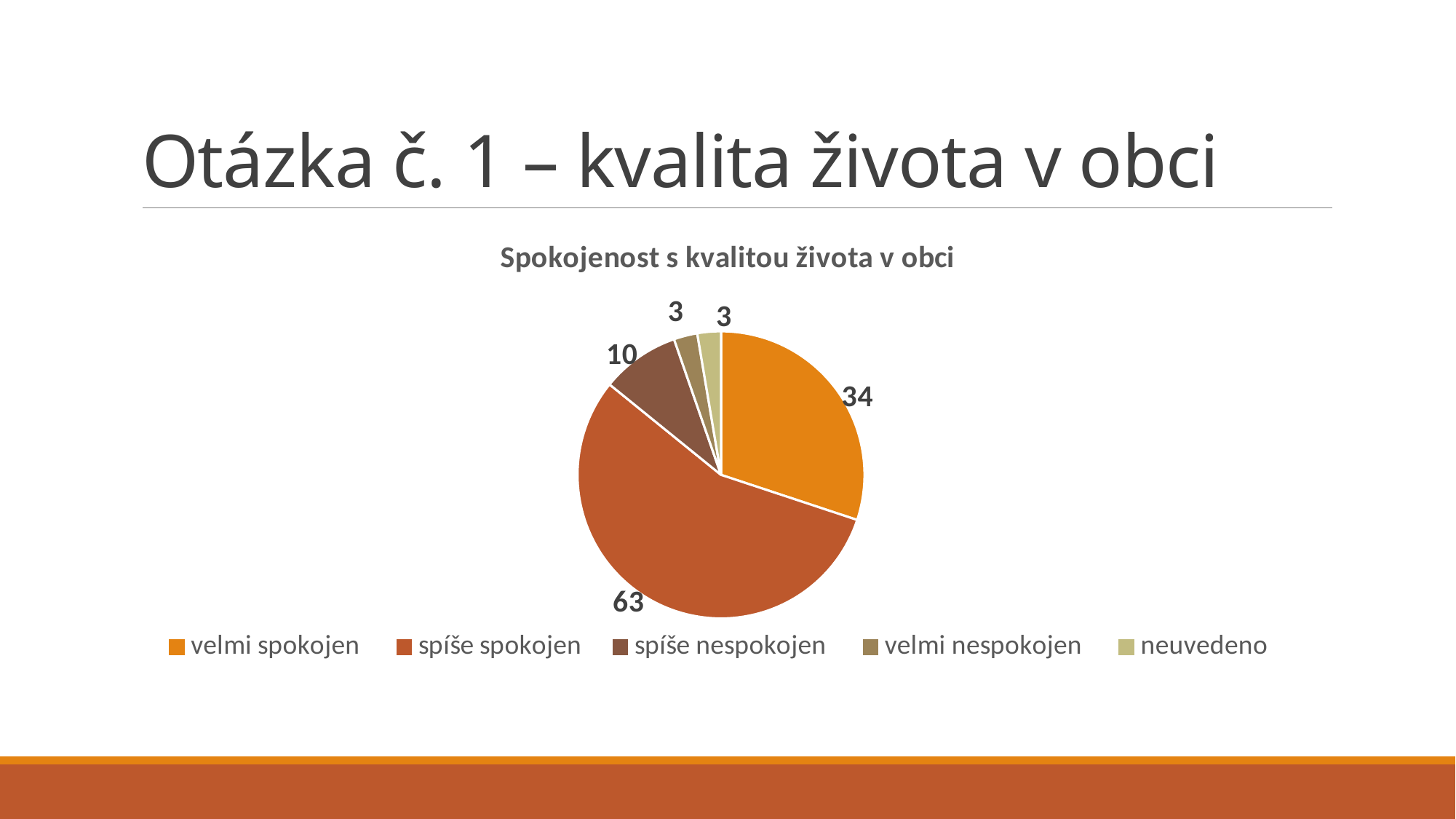
Which is larger, the value for "velmi spokojen" or the value for "spíše nespokojen"? velmi spokojen Which category has the largest slice in the pie chart? spíše spokojen What is the value for "neuvedeno" in the pie chart? 3 What is the difference between the values for "spíše spokojen" and "velmi spokojen"? 29 What type of chart is shown on the slide? pie chart What is the title of the chart? Spokojenost s kvalitou života v obci What is the difference between the values for "velmi spokojen" and "spíše nespokojen"? 24 How many categories does the pie chart show? 5 What is the value for "velmi nespokojen" in the pie chart? 3 What is the value for "spíše spokojen" in the pie chart? 63 What is the value for "velmi spokojen" in the pie chart? 34 What is the value for "spíše nespokojen" in the pie chart? 10